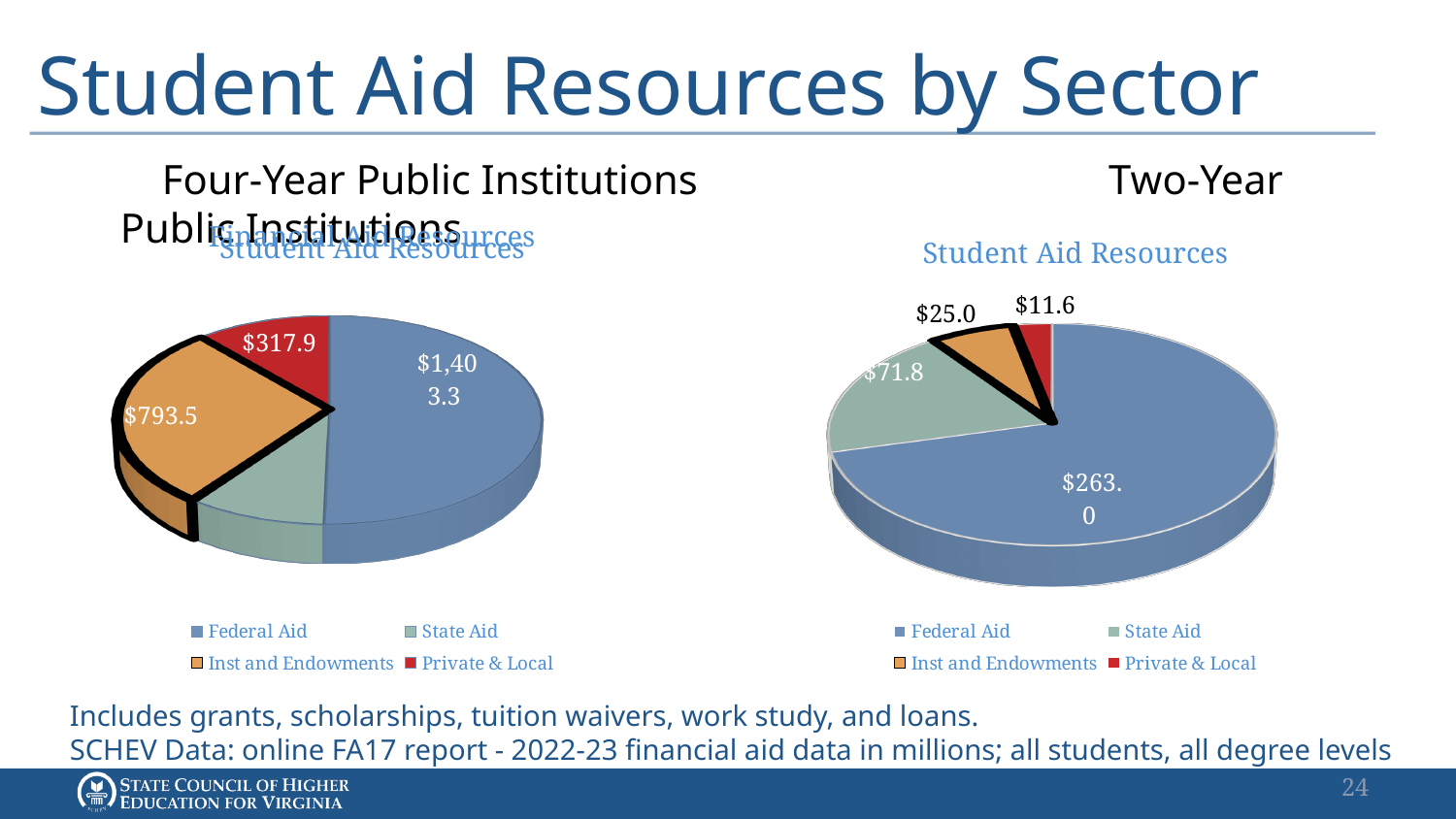
In the Two-Year Public Institutions chart, what is the difference between Federal Aid and State Aid? $191.2 What kind of chart is used for the Four-Year Public Institutions Student Aid Resources? Pie chart In the Four-Year Public Institutions chart, which is larger, Inst and Endowments or Private & Local? Inst and Endowments In the Four-Year Public Institutions chart, what is the value for Private & Local? $317.9 How many categories does the legend of the Two-Year Public Institutions chart list? 4 In the Four-Year Public Institutions chart, what is the difference between Federal Aid and Inst and Endowments? $609.8 In the Four-Year Public Institutions chart, what is the value for Federal Aid? $1,403.3 In the Two-Year Public Institutions chart, which category has the smallest value? Private & Local In the Two-Year Public Institutions chart, what is the value for State Aid? $71.8 In the Four-Year Public Institutions chart, what is the value for Inst and Endowments? $793.5 In the Two-Year Public Institutions chart, what is the value for Federal Aid? $263.0 In the Four-Year Public Institutions chart, which category has the largest value? Federal Aid